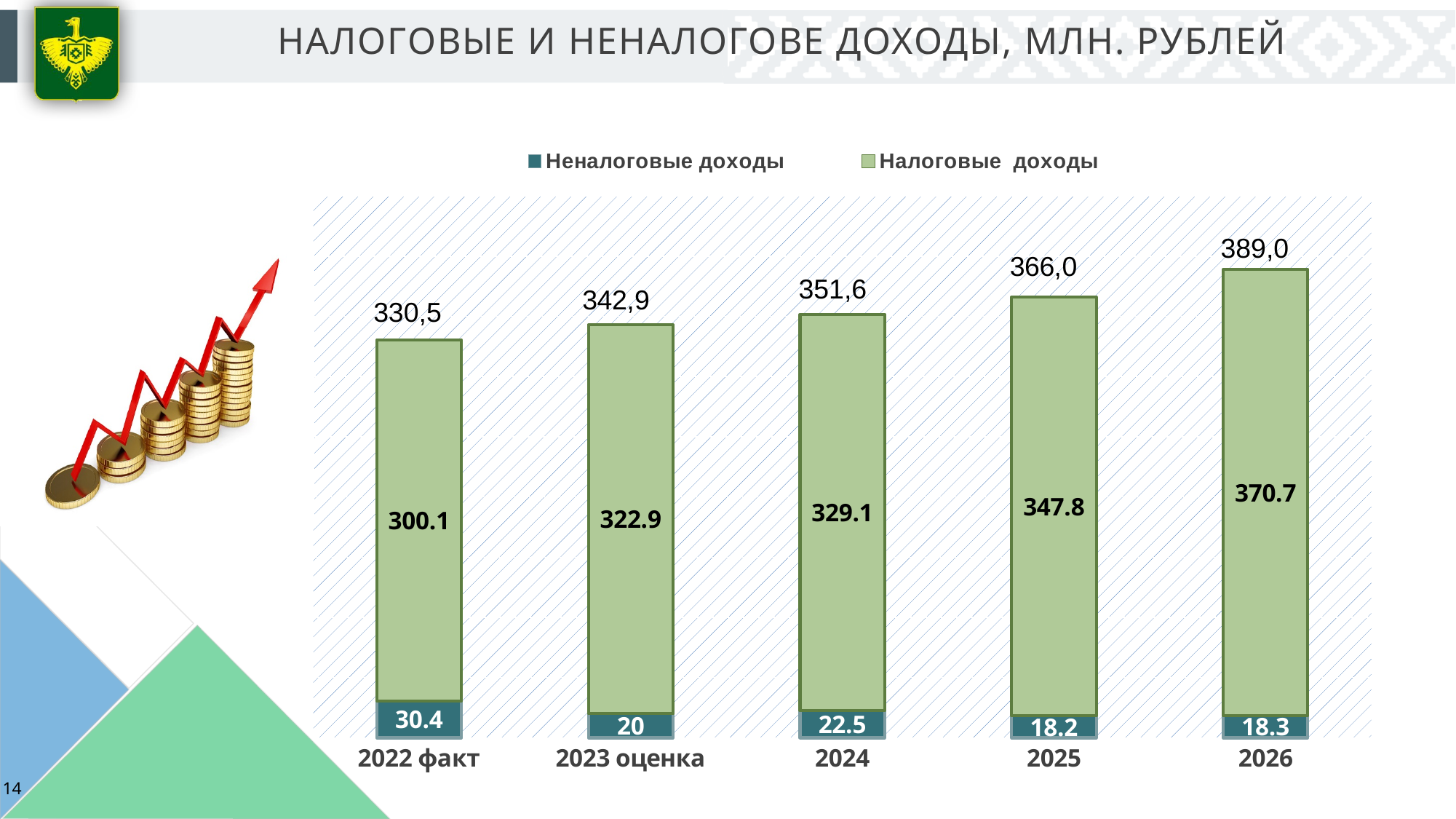
What is the difference between Налоговые доходы in 2026 and in 2025? 22.9 How many series does the legend list? 2 How many categories are shown on the x axis? 5 Which category has the lowest value of Налоговые доходы? 2022 факт What is the value of Налоговые доходы for 2022 факт? 300.1 What type of chart is shown on the slide? Stacked bar chart What is the total shown above the bar for 2025? 366,0 Which is larger: Неналоговые доходы in 2024 or in 2025? 2024 What is the value of Неналоговые доходы for 2023 оценка? 20 Which category has the highest value of Неналоговые доходы? 2022 факт What is the value of Налоговые доходы for 2026? 370.7 Do the bar totals rise or fall from 2022 факт to 2026? Rise